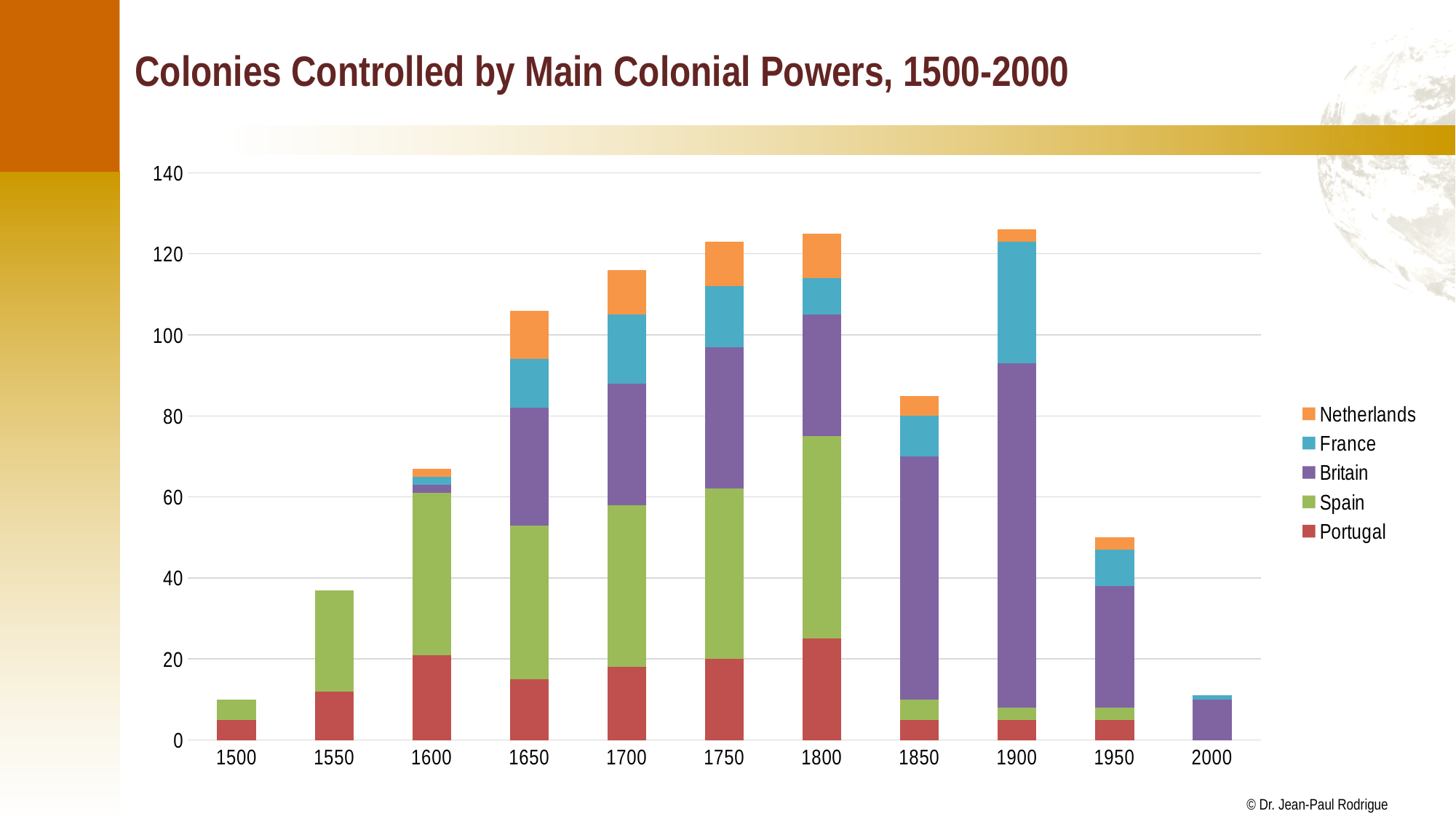
Is the total bar height for 1550 greater or less than 40? less Is the total bar height for 1850 greater or less than 100? less How many year categories are shown on the x axis? 11 Is the total bar height for 1950 greater or less than 40? greater Do the total bar heights rise or fall from 1900 to 2000? fall Which year has the taller total bar, 1750 or 1850? 1750 What kind of chart is shown on the slide? stacked bar chart Do the total bar heights rise or fall from 1500 to 1800? rise Which year has the taller total bar, 1600 or 1650? 1650 Which colonial power is shown in purple in the legend? Britain How many series does the legend list? 5